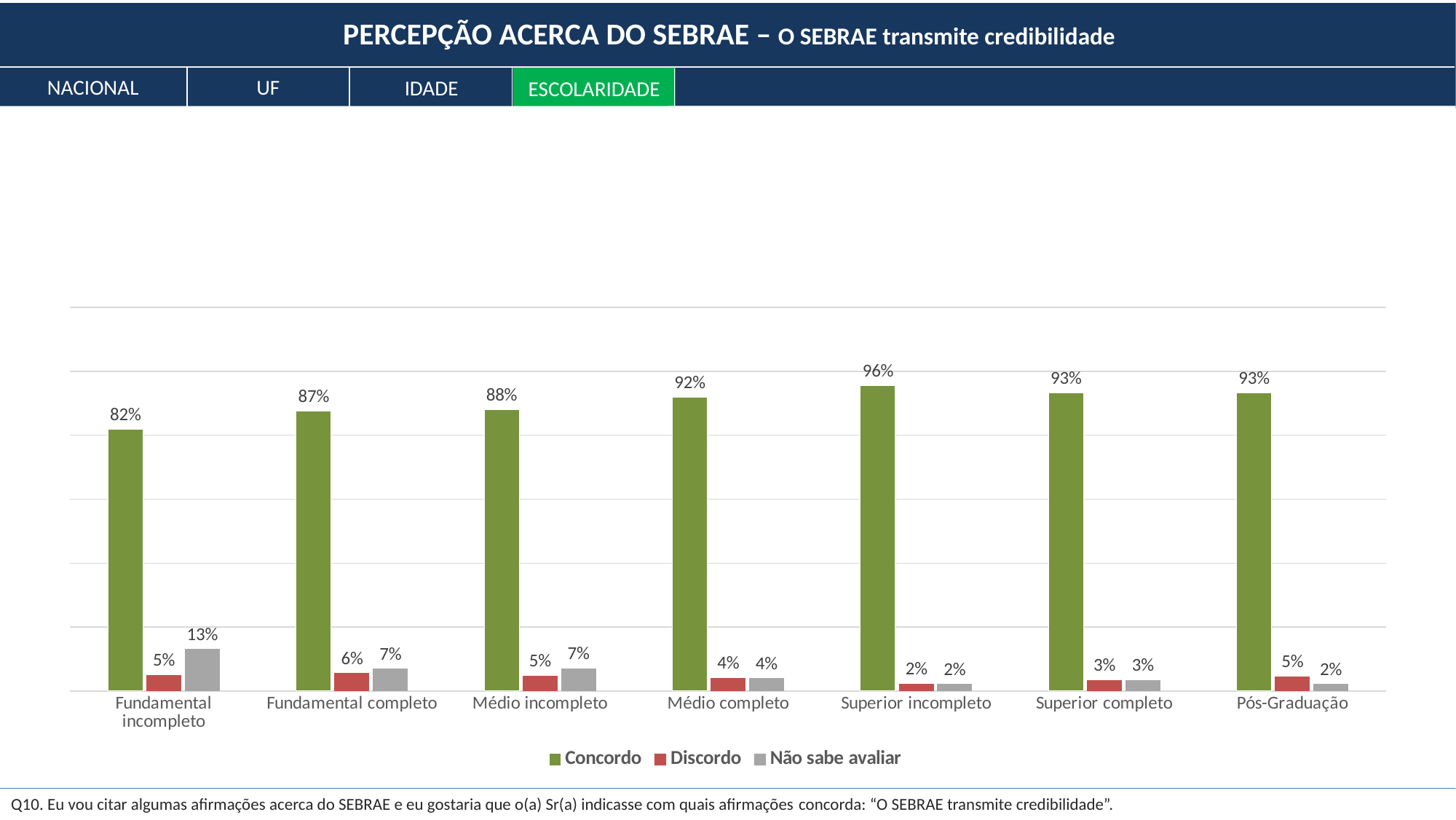
What is the Não sabe avaliar value for Fundamental incompleto? 13% How many series does the legend list? 3 Which is larger, the Concordo value for Médio completo or for Médio incompleto? Médio completo Which education level has the highest Concordo value? Superior incompleto What is the difference between the Concordo values for Superior incompleto and Fundamental incompleto? 14 percentage points Which education level has the lowest Concordo value? Fundamental incompleto How many education levels are shown on the x axis? 7 Which tab is highlighted in green on the slide? ESCOLARIDADE What kind of chart is shown on the slide? Bar chart What is the Discordo value for Fundamental completo? 6% What is the Concordo value for Superior incompleto? 96% Which education level has the highest Não sabe avaliar value? Fundamental incompleto